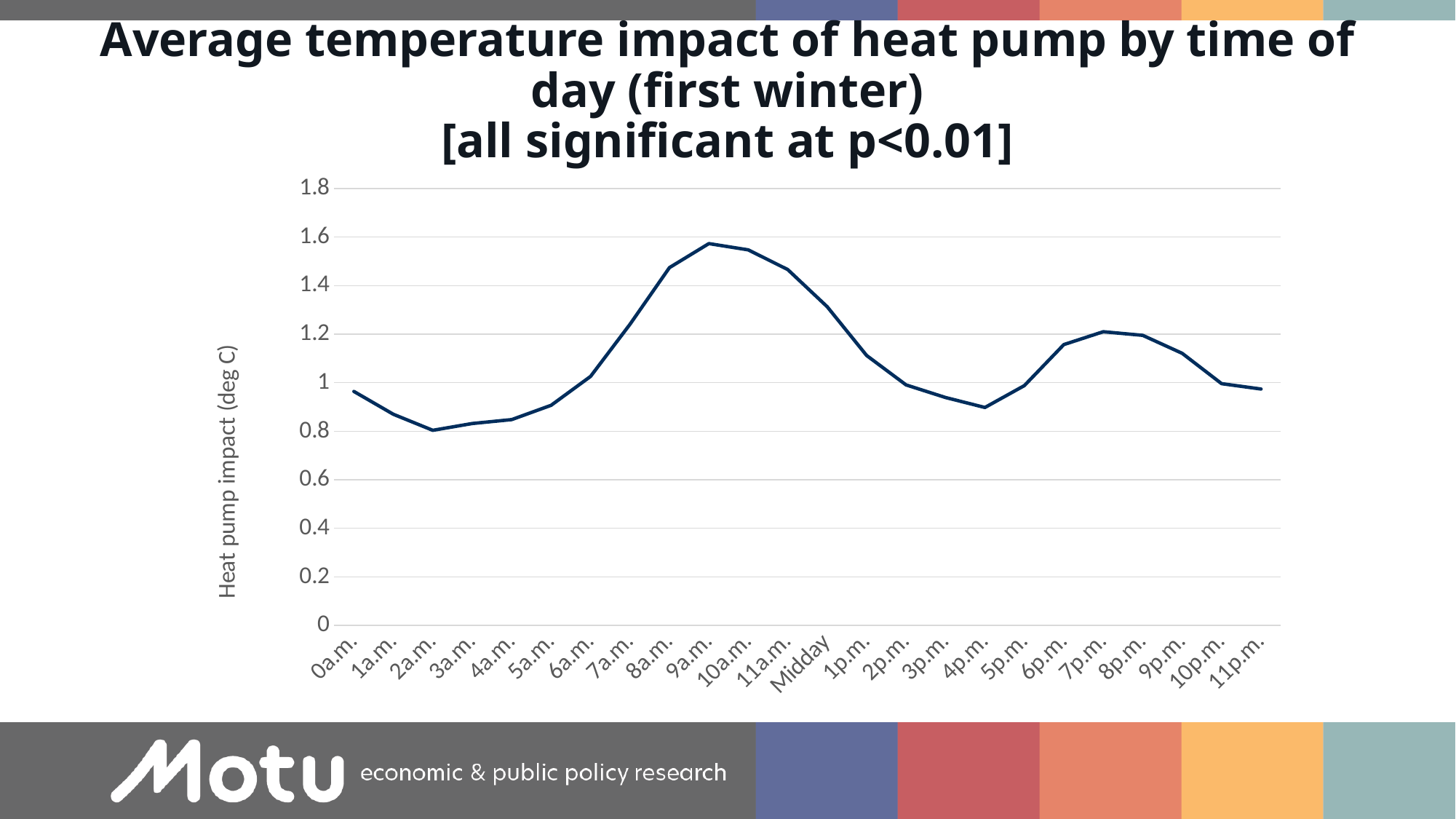
How many time-of-day points are plotted on the x axis? 24 Does the heat pump impact rise or fall between 9a.m. and 4p.m.? fall Is the value for 4p.m. greater or less than 1? less Is the value for 9a.m. greater or less than 1.4? greater What kind of chart is shown on the slide? line chart Is the value for 2a.m. greater or less than 1? less Does the heat pump impact rise or fall between 2a.m. and 9a.m.? rise What is the label on the y axis of the chart? Heat pump impact (deg C) At which time of day is the heat pump impact highest? 9a.m. At which time of day is the heat pump impact lowest? 2a.m. Which has the larger heat pump impact, 9a.m. or 7p.m.? 9a.m.